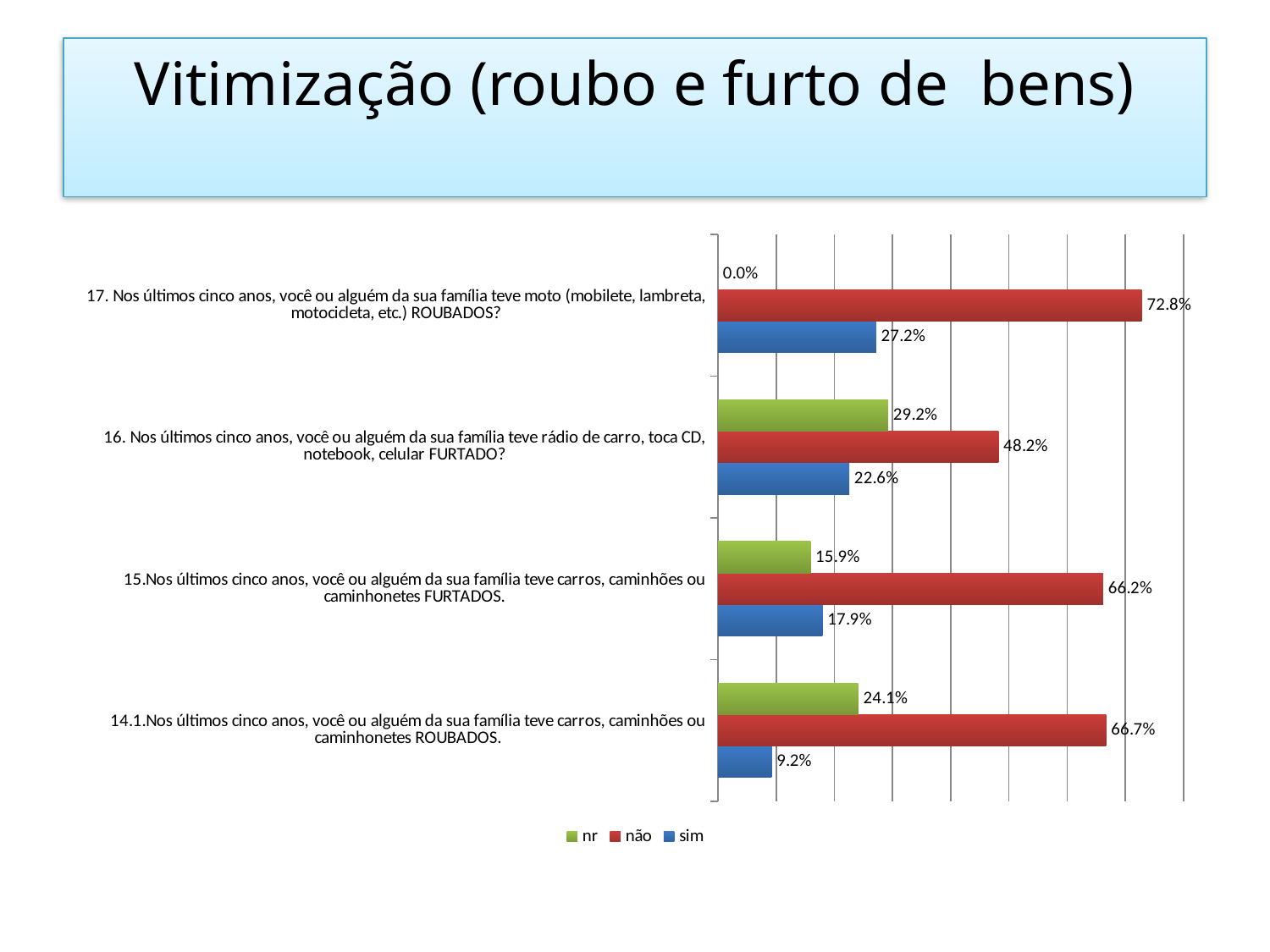
What is the value of "sim" for question 15 (carros, caminhões ou caminhonetes FURTADOS)? 17.9% What kind of chart is shown on the slide? bar chart Which question has the highest "não" value? 17. Nos últimos cinco anos, você ou alguém da sua família teve moto (mobilete, lambreta, motocicleta, etc.) ROUBADOS? What is the value of "nr" for question 16 (rádio de carro, toca CD, notebook, celular FURTADO)? 29.2% Which series is shown in red in the legend? não Which question has the lowest "sim" value? 14.1.Nos últimos cinco anos, você ou alguém da sua família teve carros, caminhões ou caminhonetes ROUBADOS. What is the difference between the "não" and "sim" values for question 16? 25.6% How many series does the legend list? 3 What is the value of "sim" for question 14.1 (carros, caminhões ou caminhonetes ROUBADOS)? 9.2% For question 15, which is larger: the "sim" value or the "nr" value? sim What is the value of "não" for question 17 (moto ROUBADOS)? 72.8% How many categories (questions) are plotted on the chart? 4